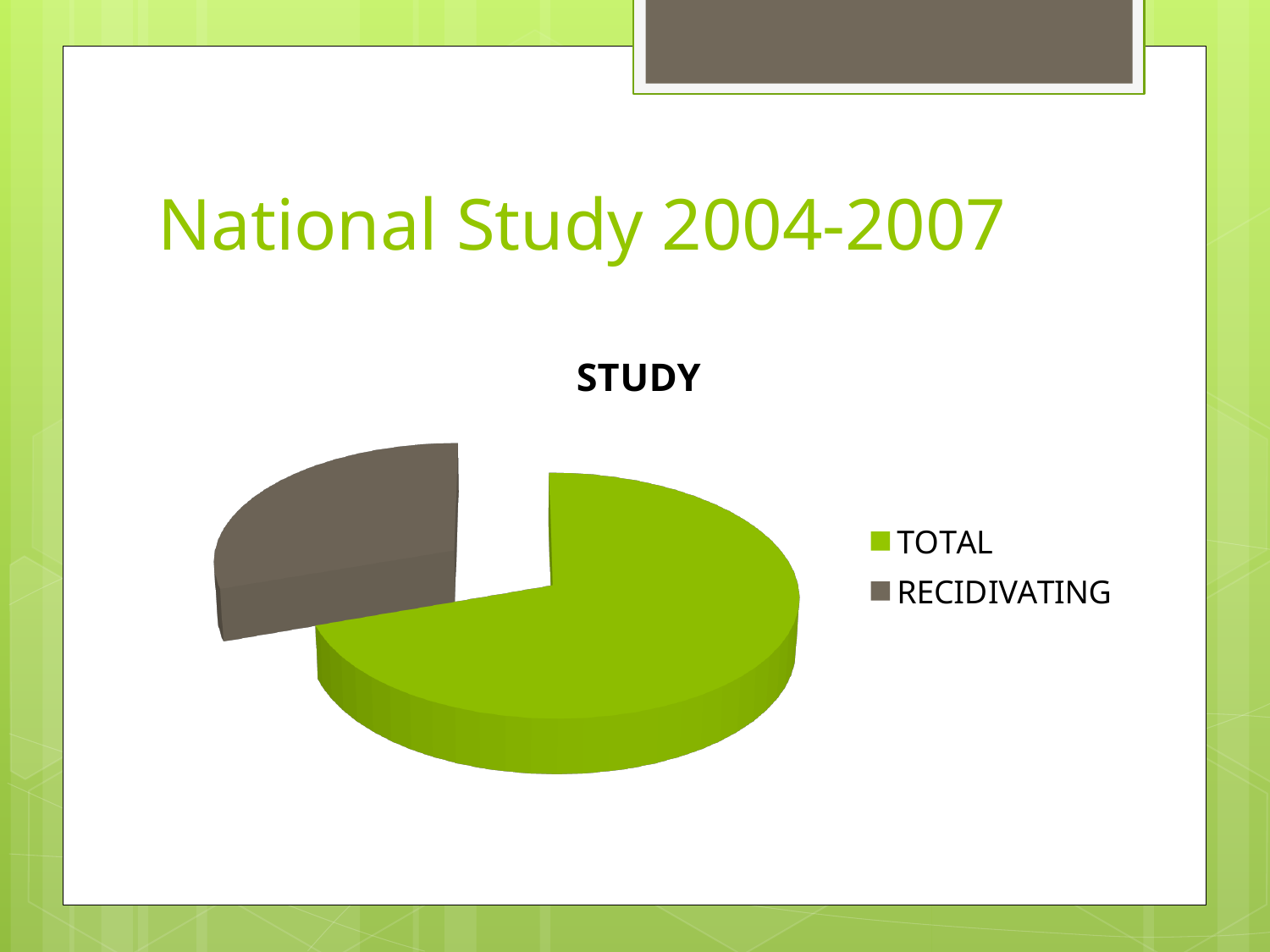
Which slice of the pie is the largest? TOTAL What colour is the RECIDIVATING slice? grey Which slice of the pie is the smallest? RECIDIVATING What kind of chart is shown on the slide? pie chart How many slices does the pie chart have? 2 How many entries does the legend list? 2 What is the title of the chart? STUDY Which slice is larger, TOTAL or RECIDIVATING? TOTAL